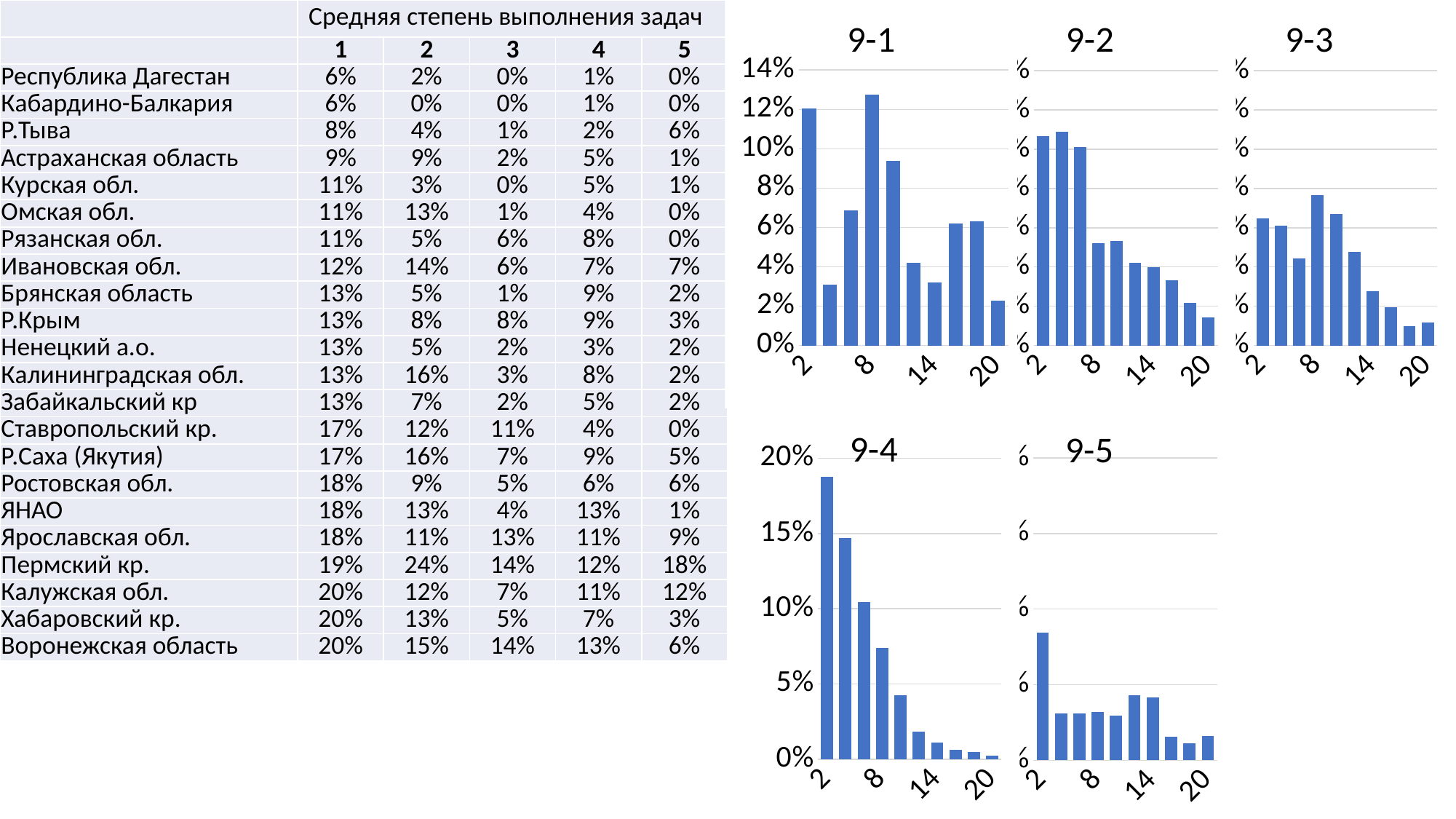
In the chart titled 9-4, is the value of the bar at x = 8 greater or less than 5%? greater What is the highest value shown on the y axis of the chart titled 9-4? 20% In the chart titled 9-1, is the value of the bar at x = 14 greater or less than 4%? less What kind of chart is the chart titled 9-1? bar chart How many bars are plotted in the chart titled 9-4? 10 How many bar charts are shown on the slide? 5 In the chart titled 9-1, is the value of the bar at x = 2 greater or less than 10%? greater In the chart titled 9-4, which bar is the tallest? the bar at x = 2 In the chart titled 9-4, do the bar values generally rise or fall as x increases? fall In the chart titled 9-1, which bar is taller: the one at x = 8 or the one at x = 14? x = 8